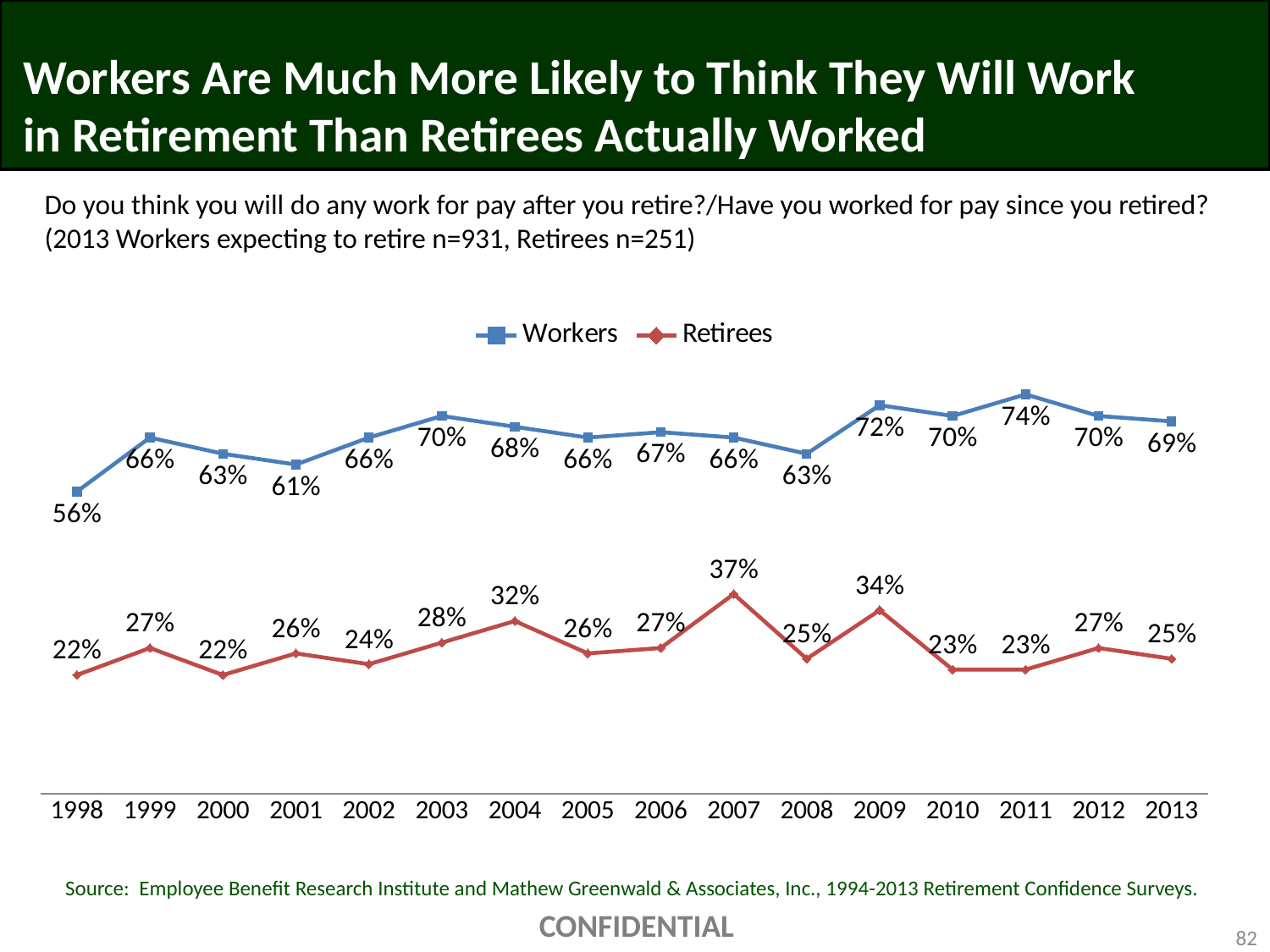
In which year is the Retirees value highest? 2007 What is the value for Retirees in 2007? 37% How many years are plotted along the x axis? 16 Which is larger, the Retirees value in 2009 or the Retirees value in 2010? 2009 What is the difference between the Workers and Retirees values in 2013? 44 percentage points How many series does the legend list? 2 What kind of chart is shown on the slide? Line chart In which year is the Workers value highest? 2011 What is the value for Workers in 1998? 56% Which series is shown in red? Retirees What is the value for Workers in 2013? 69% In which year is the Workers value lowest? 1998